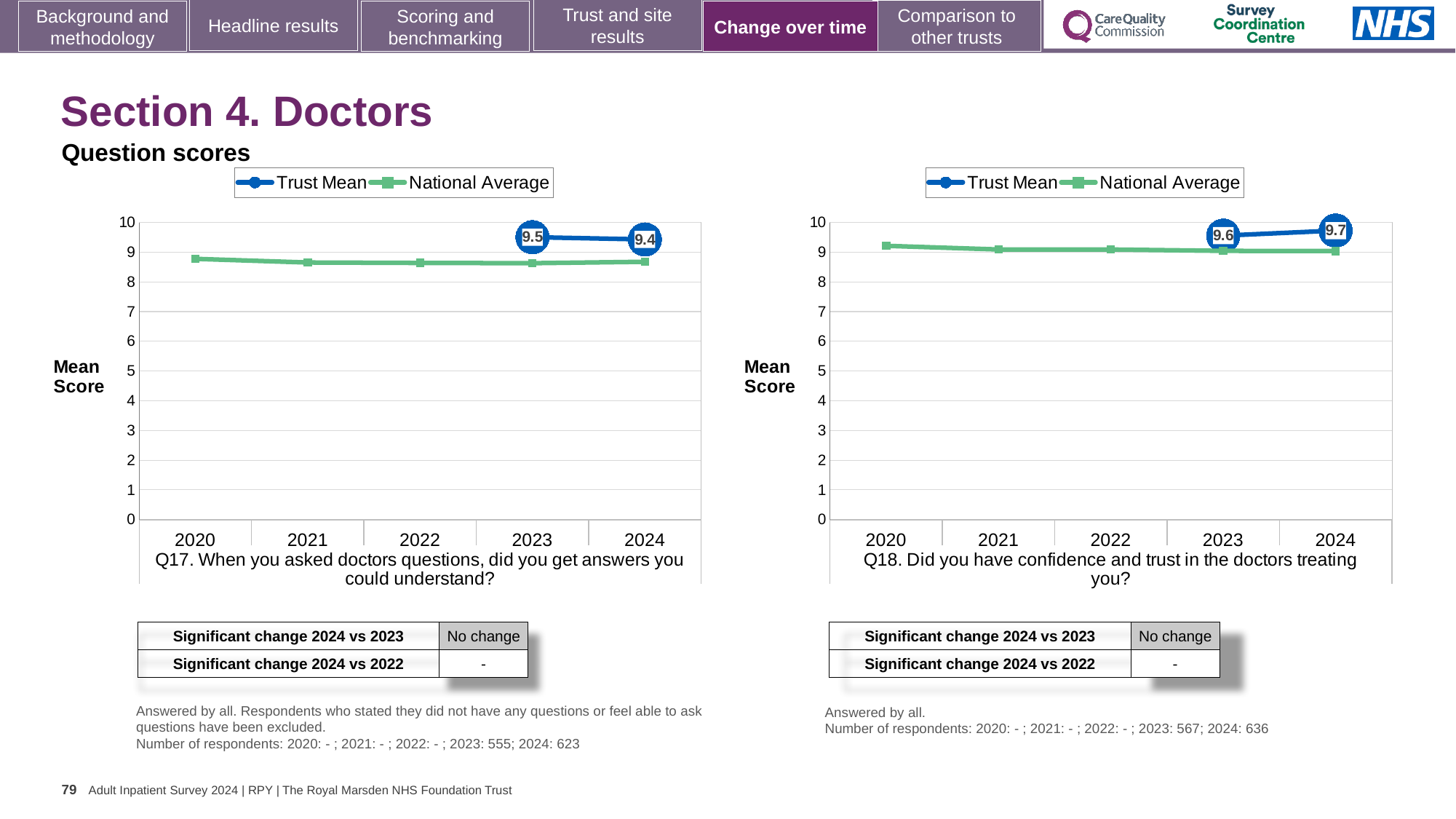
On the left chart (Q17), what is the Trust Mean value for 2024? 9.4 What kind of chart is the left chart (Q17)? Line chart On the right chart (Q18), is the National Average value for 2024 greater or less than 8? greater On the right chart (Q18), does the Trust Mean rise or fall from 2023 to 2024? Rise On the left chart (Q17), is the National Average value for 2020 greater or less than 8? greater On the right chart (Q18), what is the Trust Mean value for 2023? 9.6 On the left chart (Q17), what is the difference between the Trust Mean values for 2023 and 2024? 0.1 How many years are shown on the x axis of the left chart (Q17)? 5 How many series does the legend of the right chart (Q18) list? 2 On the right chart (Q18), what is the Trust Mean value for 2024? 9.7 On the left chart (Q17), what is the Trust Mean value for 2023? 9.5 On the right chart (Q18), which year has the higher Trust Mean value, 2023 or 2024? 2024